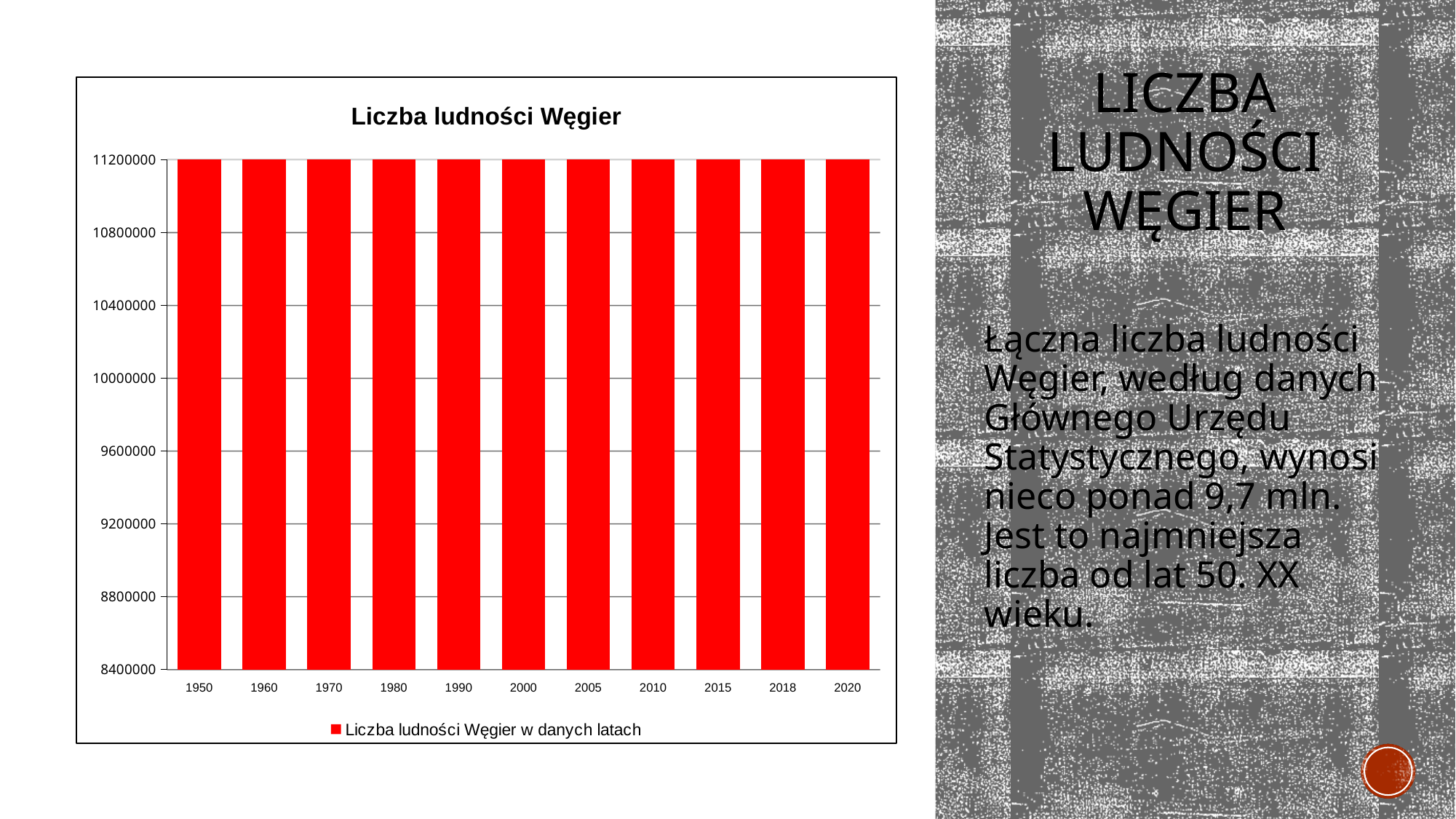
How many years are shown on the x axis of the chart? 11 What kind of chart is shown on the slide? bar chart Is the value for 1990 greater or less than 9600000? greater Which year is the last category on the x axis? 2020 How many series does the chart legend list? 1 What is the title of the chart? Liczba ludności Węgier What is the legend entry of the chart? Liczba ludności Węgier w danych latach Which year is the first category on the x axis? 1950